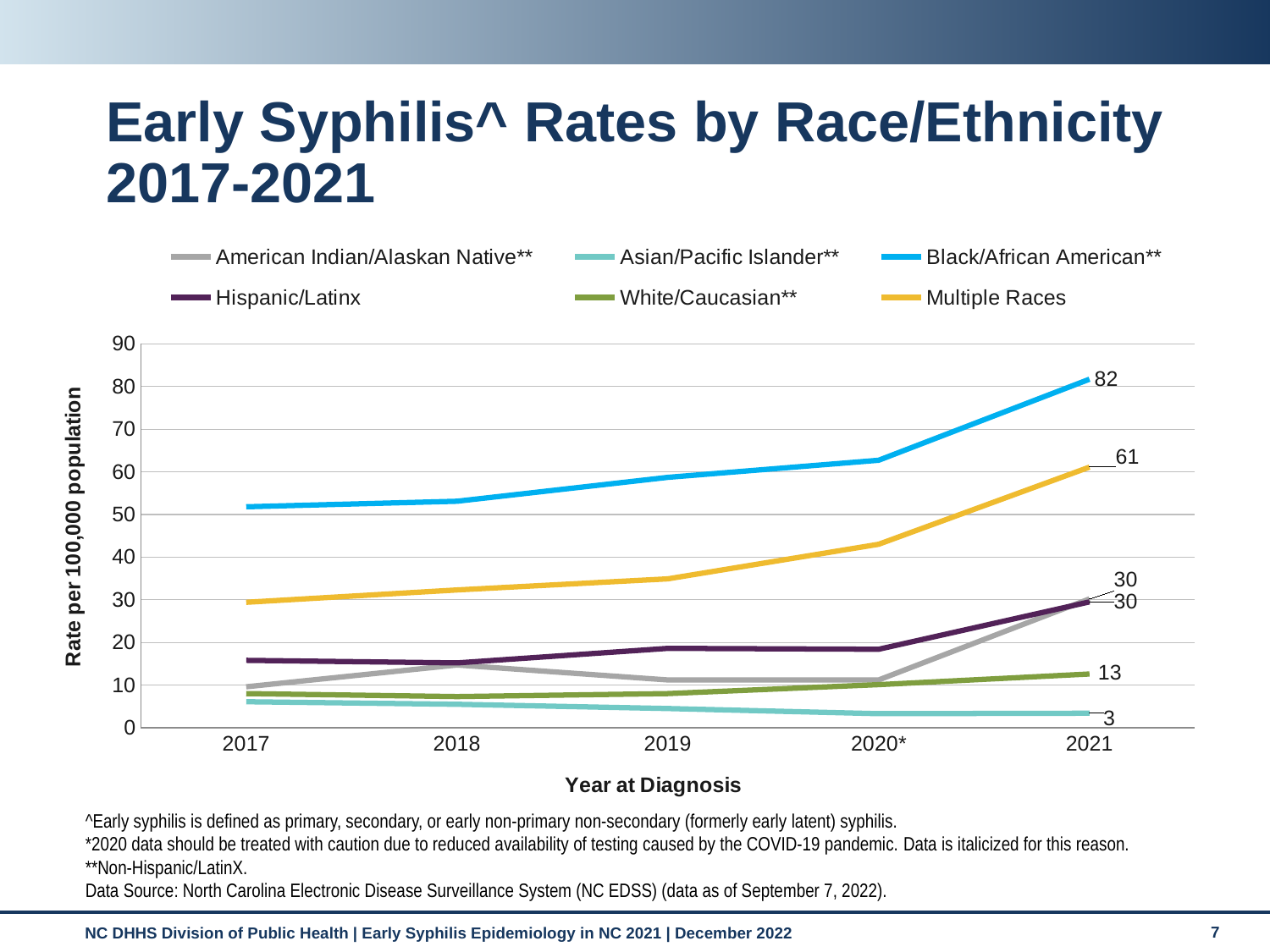
How many series does the legend list? 6 Which race/ethnicity has the highest rate in 2021? Black/African American How many years are shown on the x axis? 5 What is the difference between the 2021 rates for Black/African American and Multiple Races? 21 Which race/ethnicity has the lowest rate in 2021? Asian/Pacific Islander What type of chart is shown on the slide? line chart What is the 2021 rate for White/Caucasian? 13 Is the 2017 rate for Black/African American greater or less than 50? greater What is the 2021 rate for Asian/Pacific Islander? 3 What is the 2021 rate for Black/African American? 82 Does the rate for Multiple Races rise or fall from 2017 to 2021? rise What is the 2021 rate for Multiple Races? 61